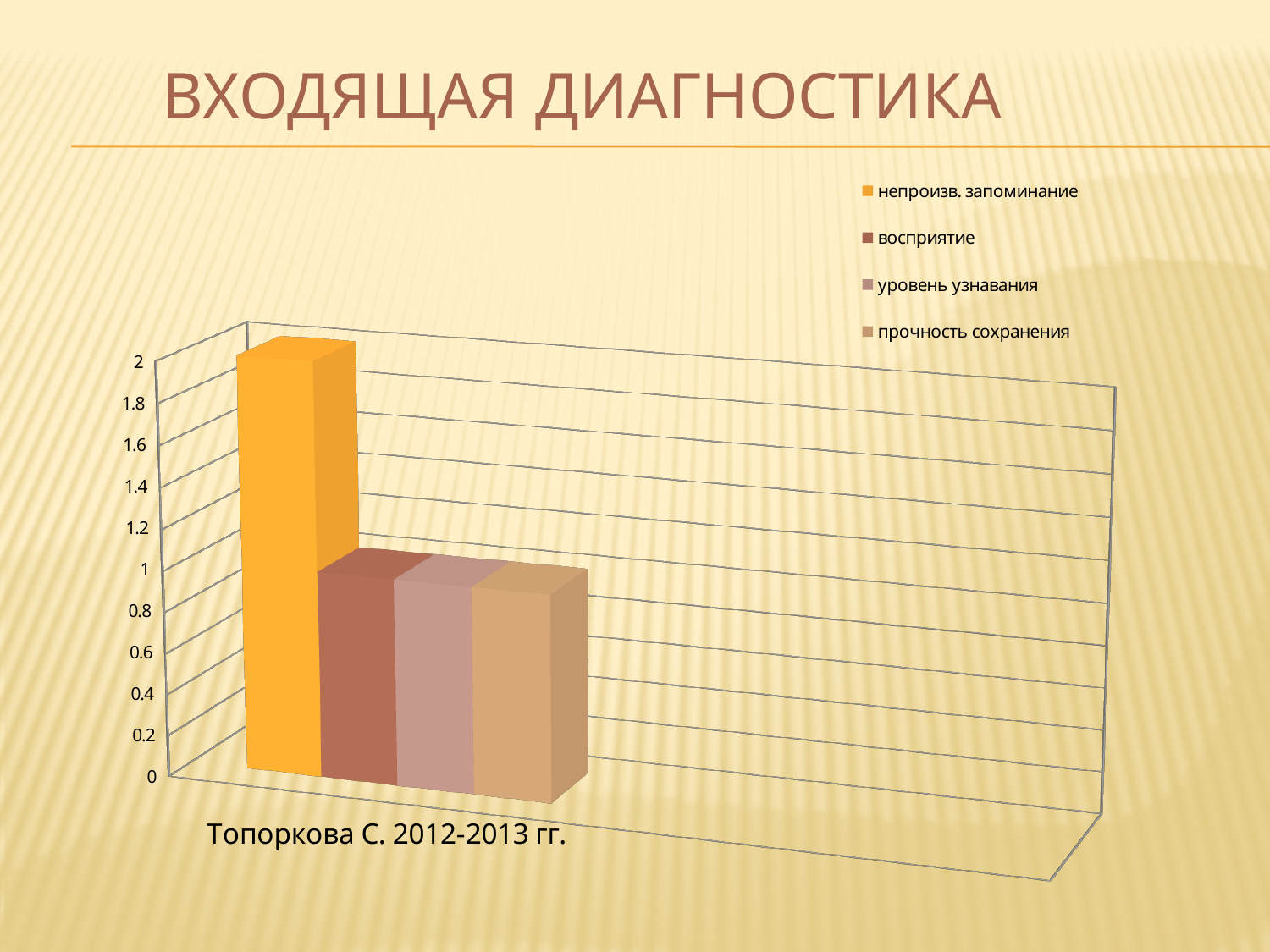
Is the value for прочность сохранения greater or less than 0.5? greater Which is larger, the value for непроизв. запоминание or the value for восприятие? непроизв. запоминание Is the value for непроизв. запоминание greater or less than 1.5? greater What is the category label shown on the x axis? Топоркова С. 2012-2013 гг. Is the value for уровень узнавания greater or less than 1.4? less How many series does the legend list? 4 What is the title of the slide containing the chart? ВХОДЯЩАЯ ДИАГНОСТИКА Which series has the highest value? непроизв. запоминание What kind of chart is shown on the slide? bar chart How many categories are shown on the x axis? 1